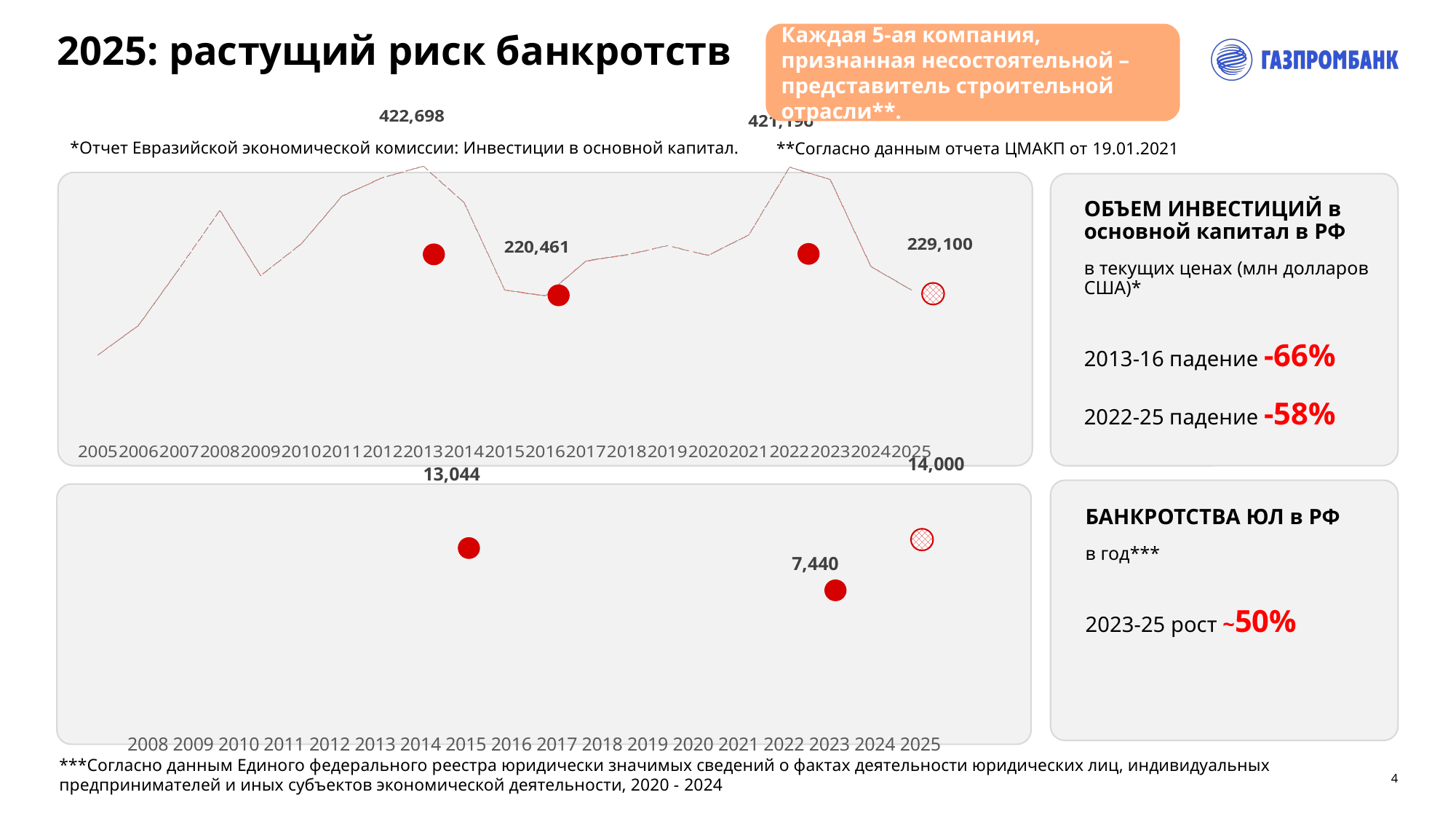
On the bottom chart (Банкротства ЮЛ в РФ), what is the value labelled for 2023? 7,440 On the bottom chart (Банкротства ЮЛ в РФ), what is the value labelled for 2015? 13,044 On the top chart (Объем инвестиций в основной капитал в РФ), what is the value labelled for 2016? 220,461 What kind of chart is the top chart (Объем инвестиций в основной капитал в РФ)? Line chart On the bottom chart (Банкротства ЮЛ в РФ), what is the difference between the 2025 value and the 2023 value? 6,560 On the top chart (Объем инвестиций в основной капитал в РФ), which is larger: the value for 2016 or the value for 2025? 2025 On the top chart (Объем инвестиций в основной капитал в РФ), what is the difference between the 2013 value and the 2016 value? 202,237 On the bottom chart (Банкротства ЮЛ в РФ), what is the value labelled for 2025? 14,000 On the top chart (Объем инвестиций в основной капитал в РФ), do the values rise or fall from 2022 to 2025? Fall On the bottom chart (Банкротства ЮЛ в РФ), how many data points are plotted? 3 On the top chart (Объем инвестиций в основной капитал в РФ), what is the value labelled for 2013? 422,698 On the top chart (Объем инвестиций в основной капитал в РФ), what is the value labelled for 2025? 229,100